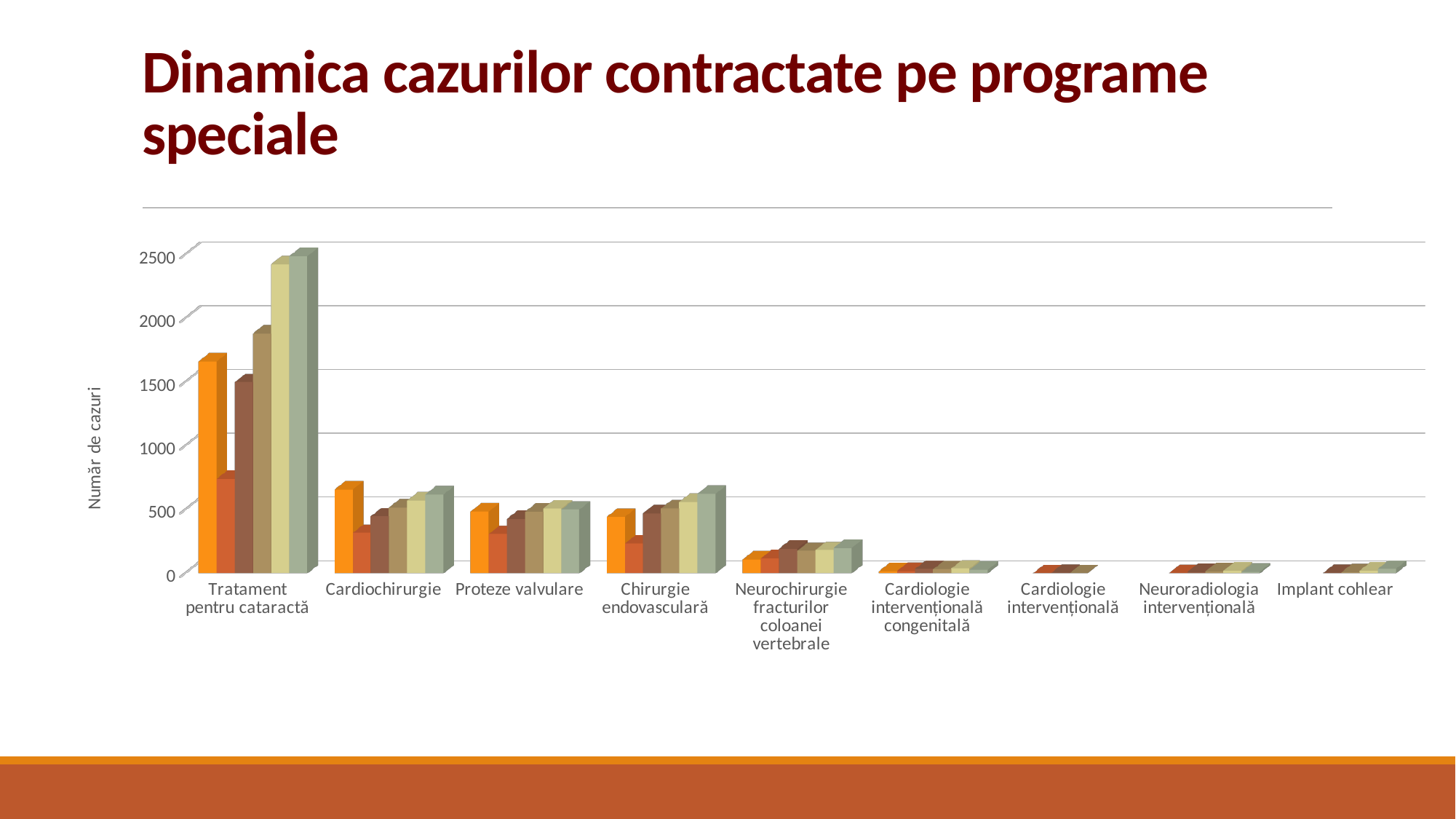
How many bars are plotted for each category in the chart? 6 Is the first (orange) bar for Tratament pentru cataractă greater or less than 1000? greater What is the label of the vertical axis of the chart? Număr de cazuri How many categories are shown on the x axis of the chart? 9 What kind of chart is shown on the slide? bar chart Is the first (orange) bar for Cardiochirurgie greater or less than 1000? less Are all the bars for Neurochirurgie fracturilor coloanei vertebrale greater or less than 500? less What is the title of the slide containing the chart? Dinamica cazurilor contractate pe programe speciale Which category has the tallest bars in the chart? Tratament pentru cataractă Which has the larger first (orange) bar, Cardiochirurgie or Proteze valvulare? Cardiochirurgie Which category has larger values, Tratament pentru cataractă or Implant cohlear? Tratament pentru cataractă